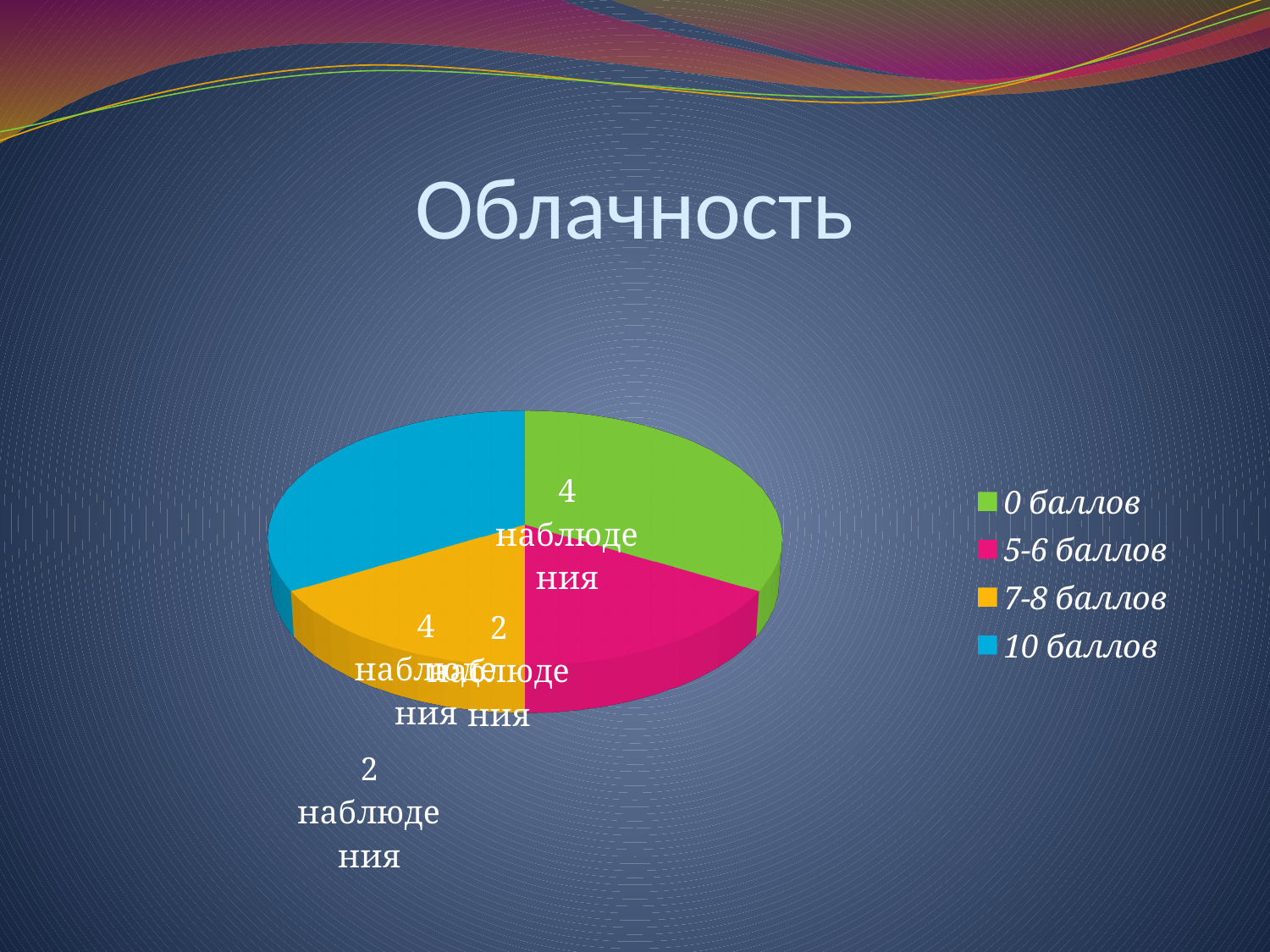
How many observations are shown for the "0 баллов" slice? 4 наблюдения What is the difference in observations between the "0 баллов" slice and the "7-8 баллов" slice? 2 Which colour represents "10 баллов" in the legend? blue What is the title of the chart on the slide? Облачность Which slice is larger, "0 баллов" or "5-6 баллов"? 0 баллов How many slices does the pie chart have? 4 What kind of chart is shown on the slide? pie chart How many observations are shown for the "7-8 баллов" slice? 2 наблюдения How many observations are shown for the "5-6 баллов" slice? 2 наблюдения How many entries does the legend list? 4 How many observations are shown for the "10 баллов" slice? 4 наблюдения Which slice is larger, "10 баллов" or "7-8 баллов"? 10 баллов